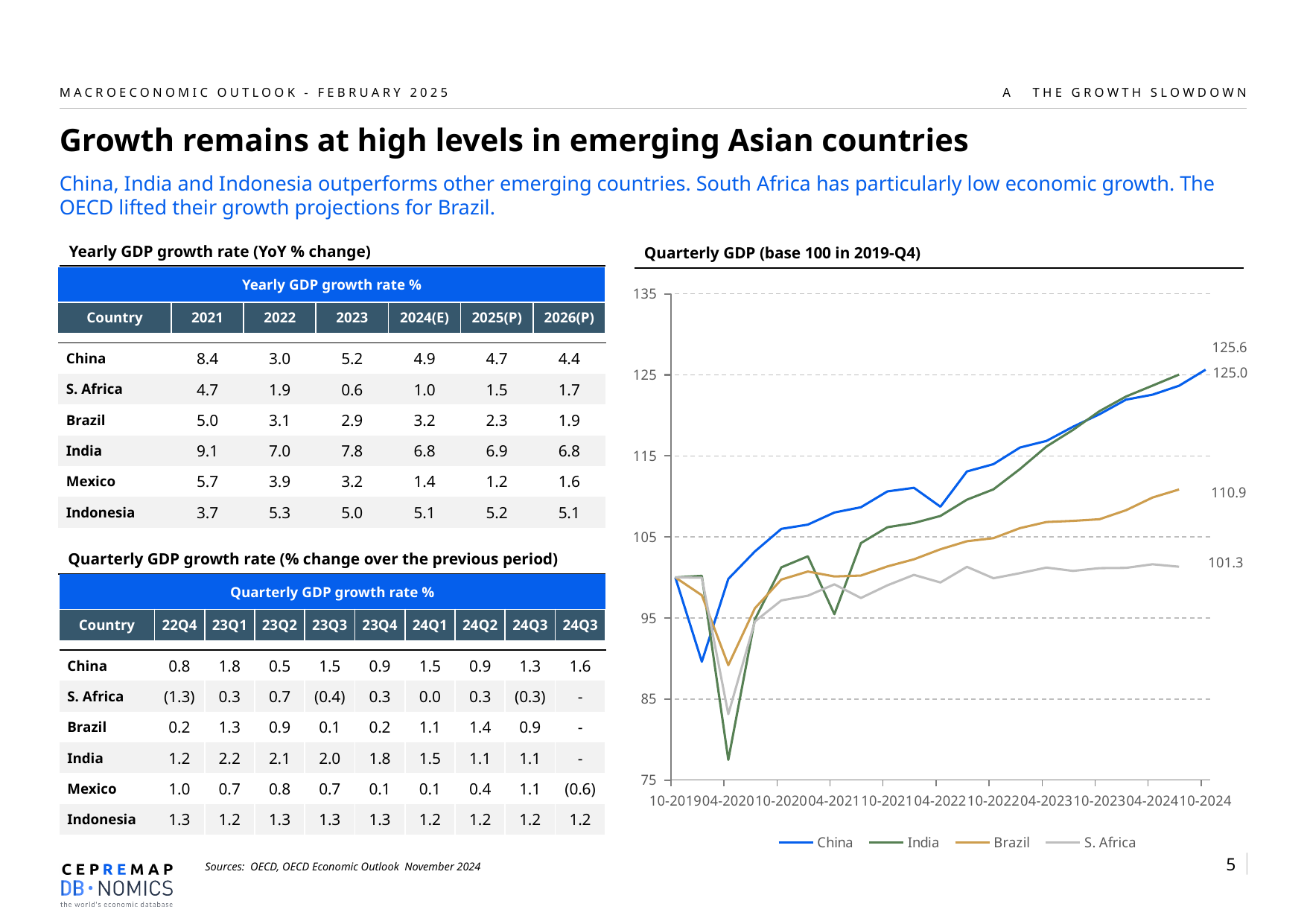
In the Quarterly GDP chart, which series has the lowest value at the end of the period? S. Africa In the Quarterly GDP chart, does the Brazil line rise or fall from 10-2020 to 10-2024? rises In the Quarterly GDP chart, what is the final labelled value for China? 125.6 In the Quarterly GDP chart, what is the final labelled value for S. Africa? 101.3 In the Quarterly GDP chart, what is the difference between the final values of Brazil and S. Africa? 9.6 In the Quarterly GDP chart, is the value for India at 04-2020 greater or less than 85? less In the Quarterly GDP chart, which is larger at the end of the period, Brazil or S. Africa? Brazil What kind of chart is the Quarterly GDP chart? line chart In the Quarterly GDP chart, what is the final labelled value for Brazil? 110.9 In the Quarterly GDP chart, what is the difference between the final values of China and Brazil? 14.7 In the Quarterly GDP chart, what is the final labelled value for India? 125.0 How many series does the legend of the Quarterly GDP chart list? 4